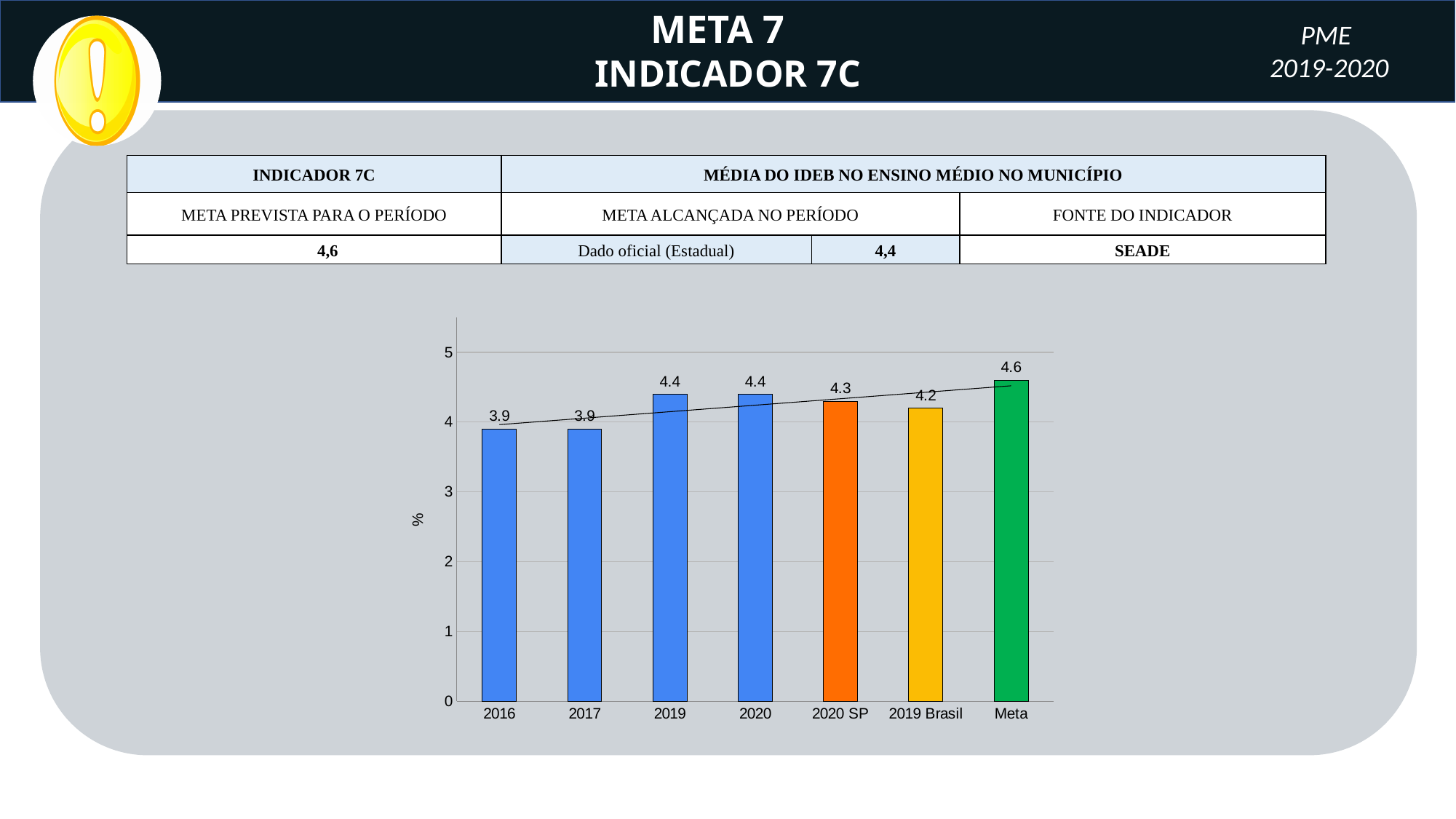
How many bars are shown in the chart? 7 What is the difference between the Meta value and the 2020 value? 0.2 What is the value for Meta? 4.6 What is the value for 2019 Brasil? 4.2 What is the value for 2020 SP? 4.3 What kind of chart is shown on the slide? bar chart Is the value for 2017 greater or less than 4? less Which category has the highest value? Meta What is the label on the vertical axis of the chart? % Which is larger, the value for 2020 SP or the value for 2019 Brasil? 2020 SP What is the value for 2016? 3.9 What is the value for 2019? 4.4